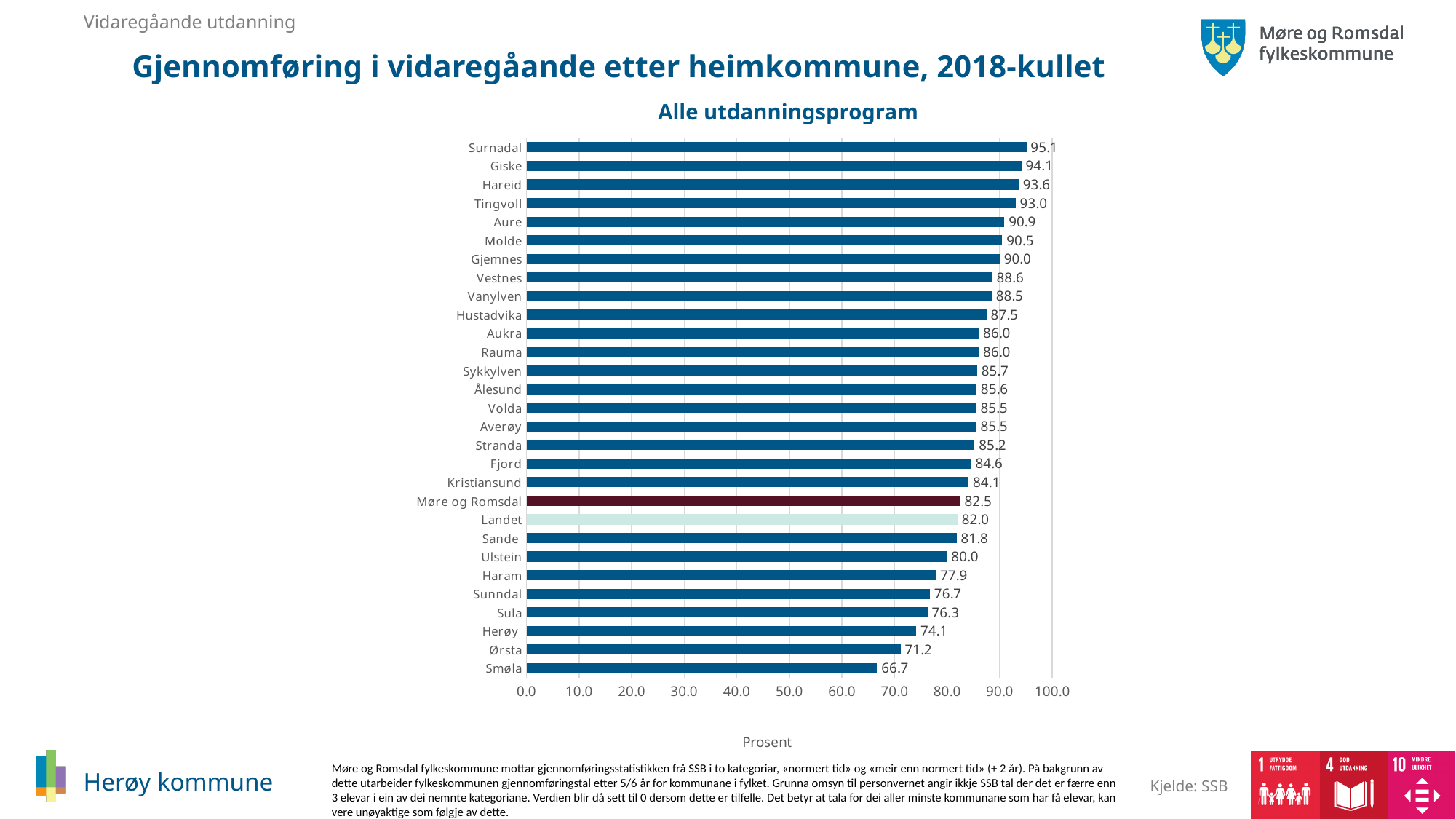
What is the value for Møre og Romsdal? 82.5 What is the title shown above the chart? Alle utdanningsprogram Is the value for Ørsta greater or less than 80.0? less What kind of chart is shown on the slide? bar chart Which has a larger value, Molde or Ålesund? Molde What is the value for Landet? 82.0 How many categories are shown in the chart? 29 What is the difference between the values for Møre og Romsdal and Herøy? 8.4 Which category has the lowest value? Smøla Which category has the highest value? Surnadal What is the difference between the values for Surnadal and Smøla? 28.4 What is the value for Herøy? 74.1